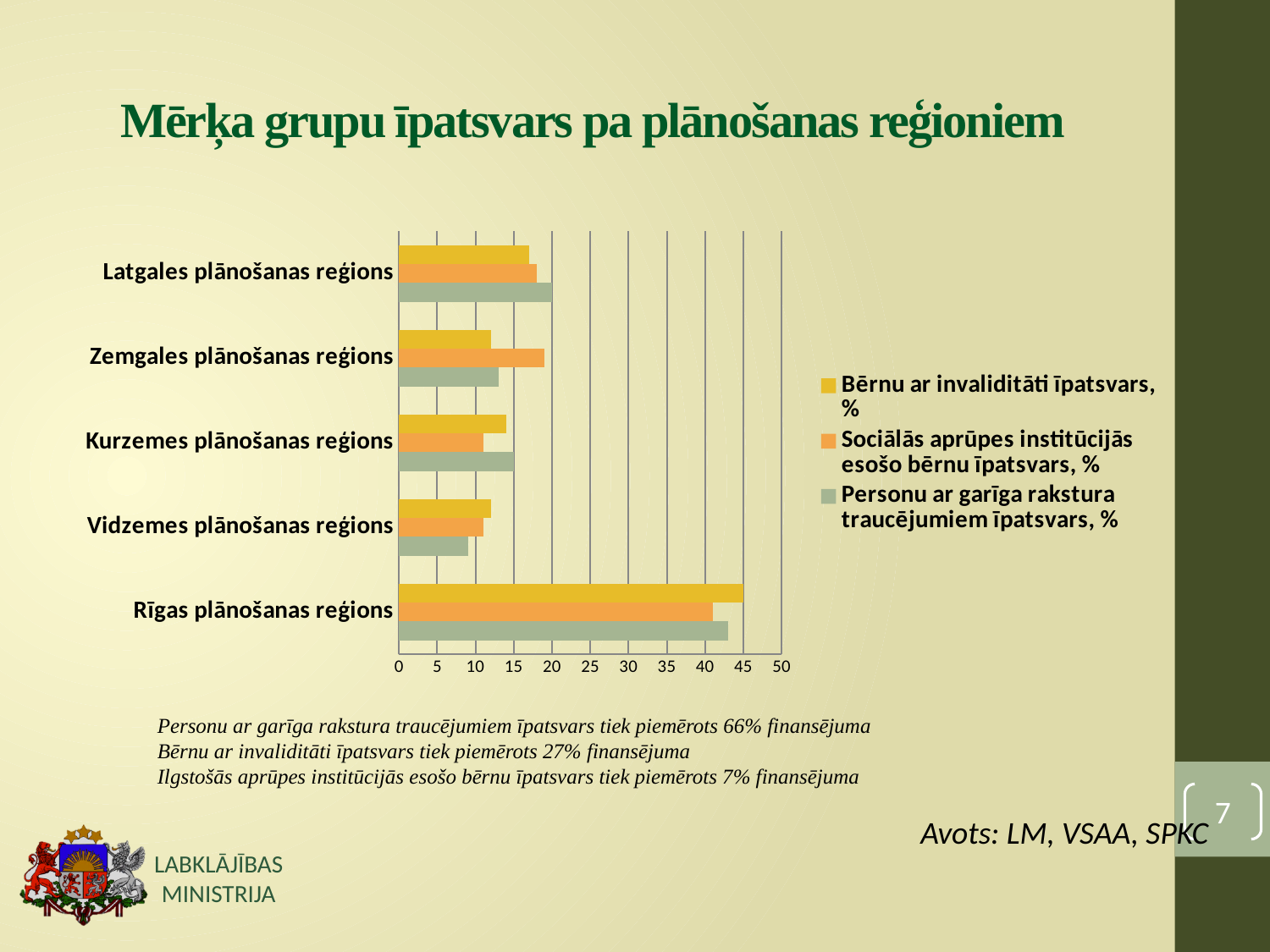
Is the value for 'Personu ar garīga rakstura traucējumiem īpatsvars, %' in Vidzemes plānošanas reģions greater or less than 10? less Which region has the lowest value for 'Personu ar garīga rakstura traucējumiem īpatsvars, %'? Vidzemes plānošanas reģions How many series does the chart legend list? 3 What kind of chart is shown on the slide? bar chart Is the value for 'Bērnu ar invaliditāti īpatsvars, %' in Latgales plānošanas reģions greater or less than 20? less Which colour represents 'Bērnu ar invaliditāti īpatsvars, %' in the chart? yellow For 'Personu ar garīga rakstura traucējumiem īpatsvars, %', which region has the larger value: Latgales plānošanas reģions or Kurzemes plānošanas reģions? Latgales plānošanas reģions How many planning regions are shown on the chart? 5 What is the title of the chart on the slide? Mērķa grupu īpatsvars pa plānošanas reģioniem Which region has the highest value for 'Bērnu ar invaliditāti īpatsvars, %'? Rīgas plānošanas reģions In Zemgales plānošanas reģions, which is larger: 'Sociālās aprūpes institūcijās esošo bērnu īpatsvars, %' or 'Bērnu ar invaliditāti īpatsvars, %'? Sociālās aprūpes institūcijās esošo bērnu īpatsvars, % Is the value for 'Sociālās aprūpes institūcijās esošo bērnu īpatsvars, %' in Rīgas plānošanas reģions greater or less than 35? greater